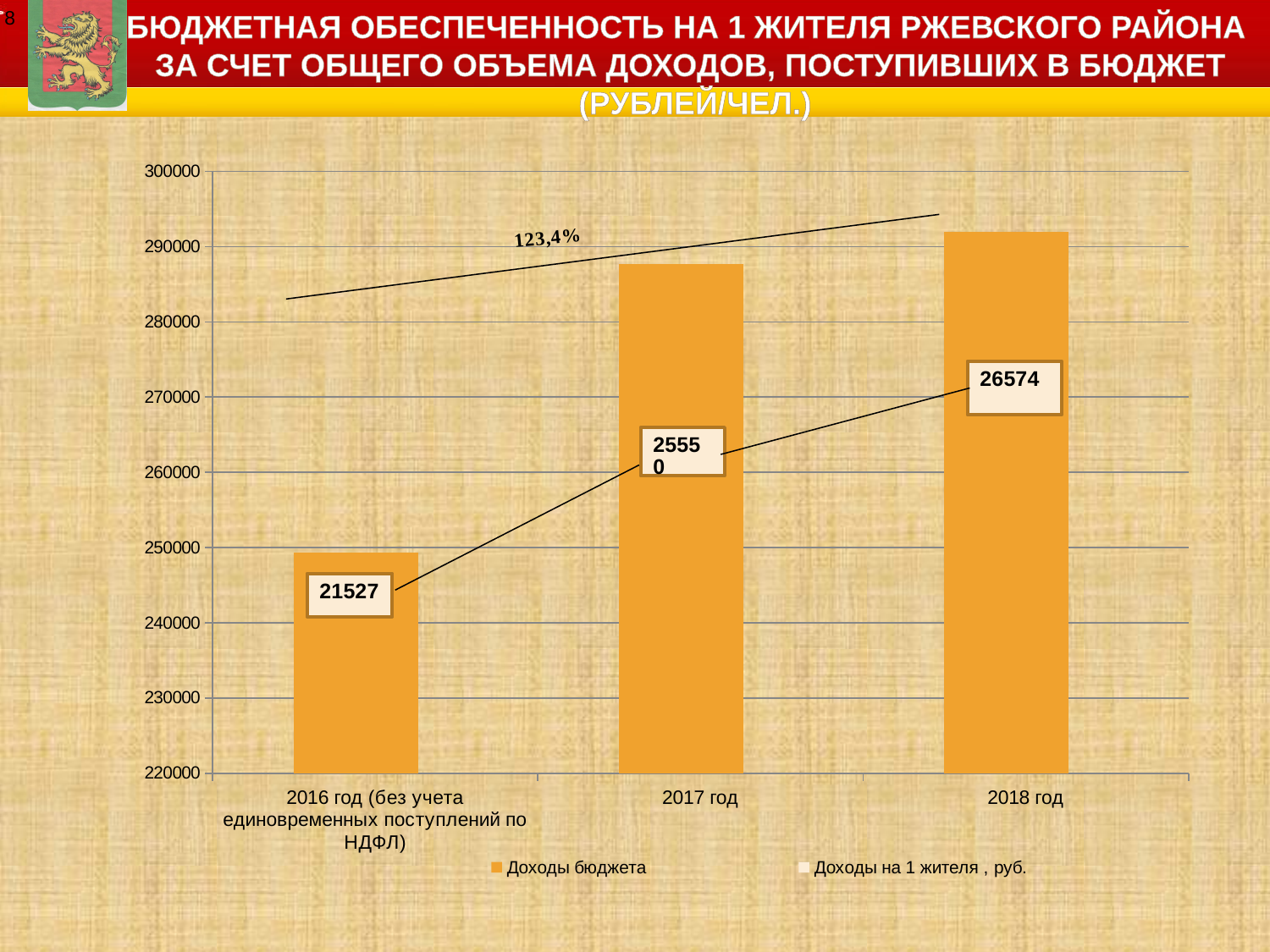
Which bar is taller, 2017 год or 2018 год? 2018 год How many bars are plotted in the chart? 3 What is the difference between the data labels for 2018 год and 2016 год? 5047 How many series does the legend list? 2 What is the data label shown on the bar for 2017 год? 25550 Is the bar for 2017 год greater or less than 280000 on the vertical axis? greater What percentage is written above the upper line in the chart? 123,4% Which year has the tallest bar? 2018 год What is the data label shown on the bar for 2018 год? 26574 Which year has the shortest bar? 2016 год (без учета единовременных поступлений по НДФЛ) What is the data label shown on the bar for 2016 год (без учета единовременных поступлений по НДФЛ)? 21527 Is the bar for 2016 год greater or less than 260000 on the vertical axis? less